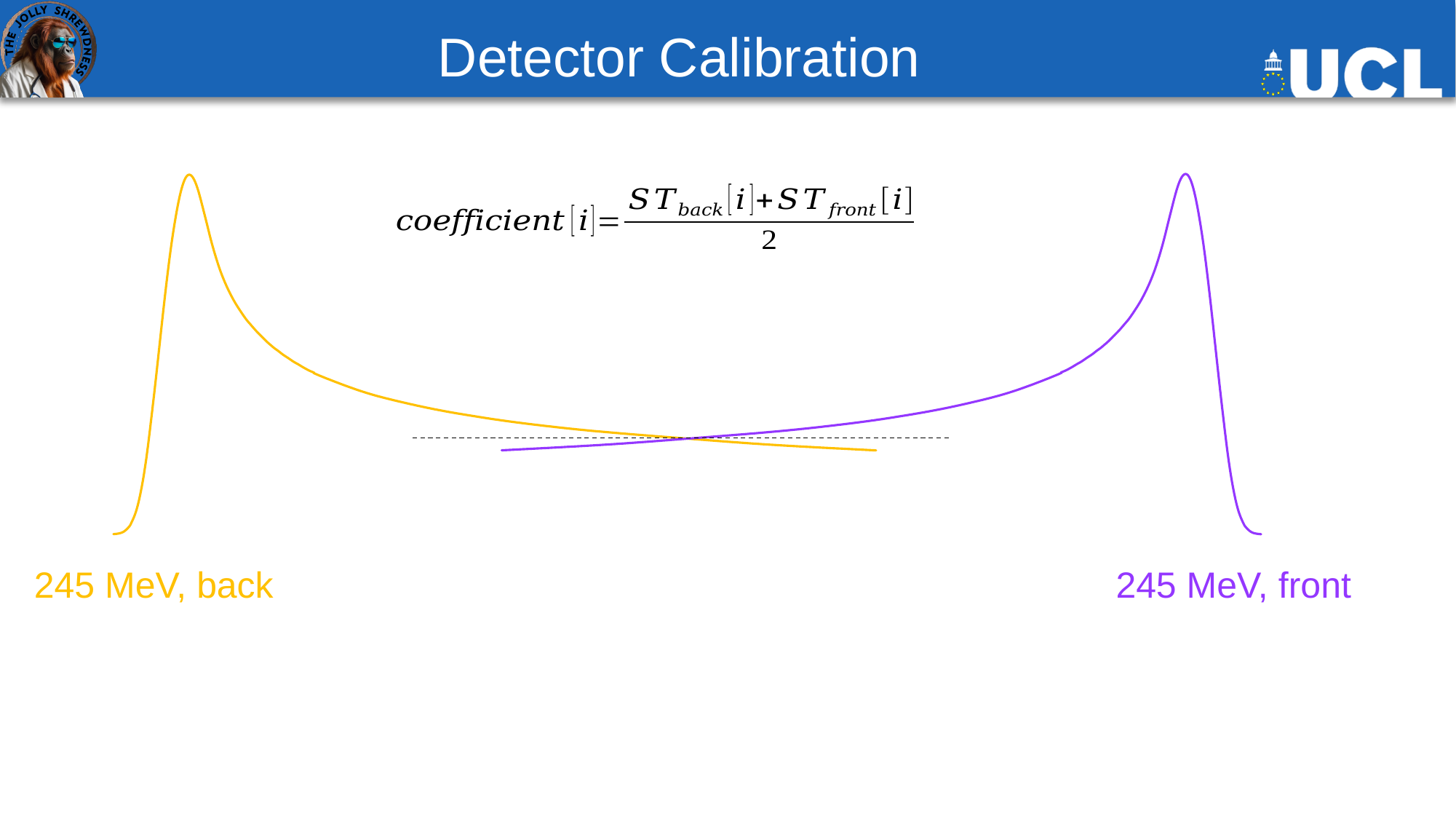
Before its peak, does the "245 MeV, front" curve rise or fall moving to the right along the x axis? rise What colour is the curve labelled "245 MeV, back"? yellow What beam energy is given in the label of the purple curve? 245 MeV What kind of chart is shown on the slide? line chart Which curve has its peak on the right side of the plot, the back curve or the front curve? front How many curves are plotted on the slide? 2 What colour is the curve labelled "245 MeV, front"? purple Which curve has its peak on the left side of the plot, the back curve or the front curve? back What beam energy is given in the label of the yellow curve? 245 MeV After its peak, does the "245 MeV, back" curve rise or fall moving to the right along the x axis? fall